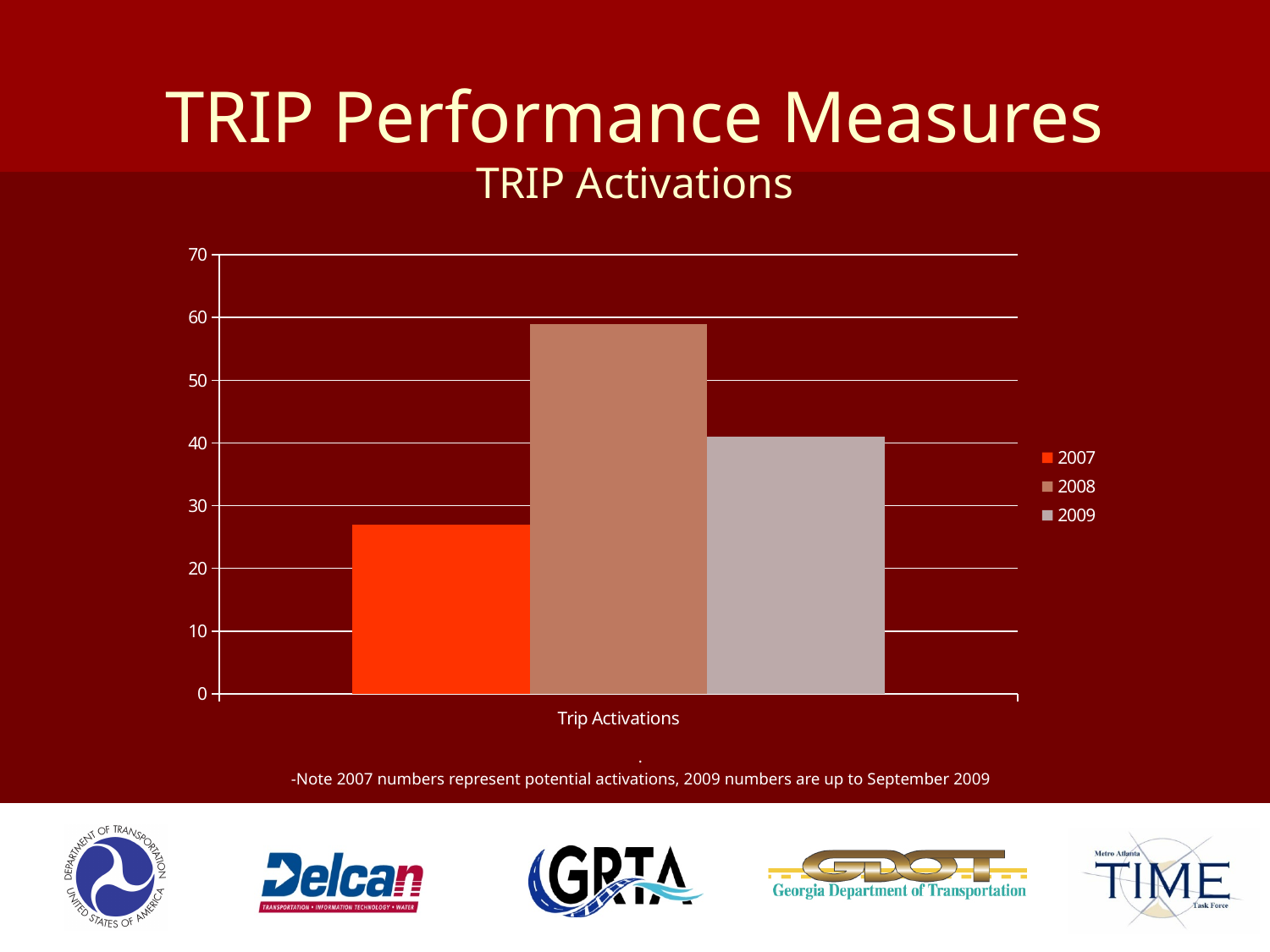
Is the Trip Activations value for 2009 greater or less than 50? less Which is larger, the Trip Activations value for 2007 or for 2009? 2009 Which legend entry is shown in orange? 2007 How many categories are shown on the x axis? 1 What is the title of the chart? TRIP Activations What kind of chart is shown on the slide? bar chart Is the Trip Activations value for 2008 greater or less than 50? greater Which year has the lowest number of Trip Activations? 2007 How many series does the legend list? 3 Is the Trip Activations value for 2007 greater or less than 30? less Which year has the highest number of Trip Activations? 2008 Which is larger, the Trip Activations value for 2008 or for 2009? 2008